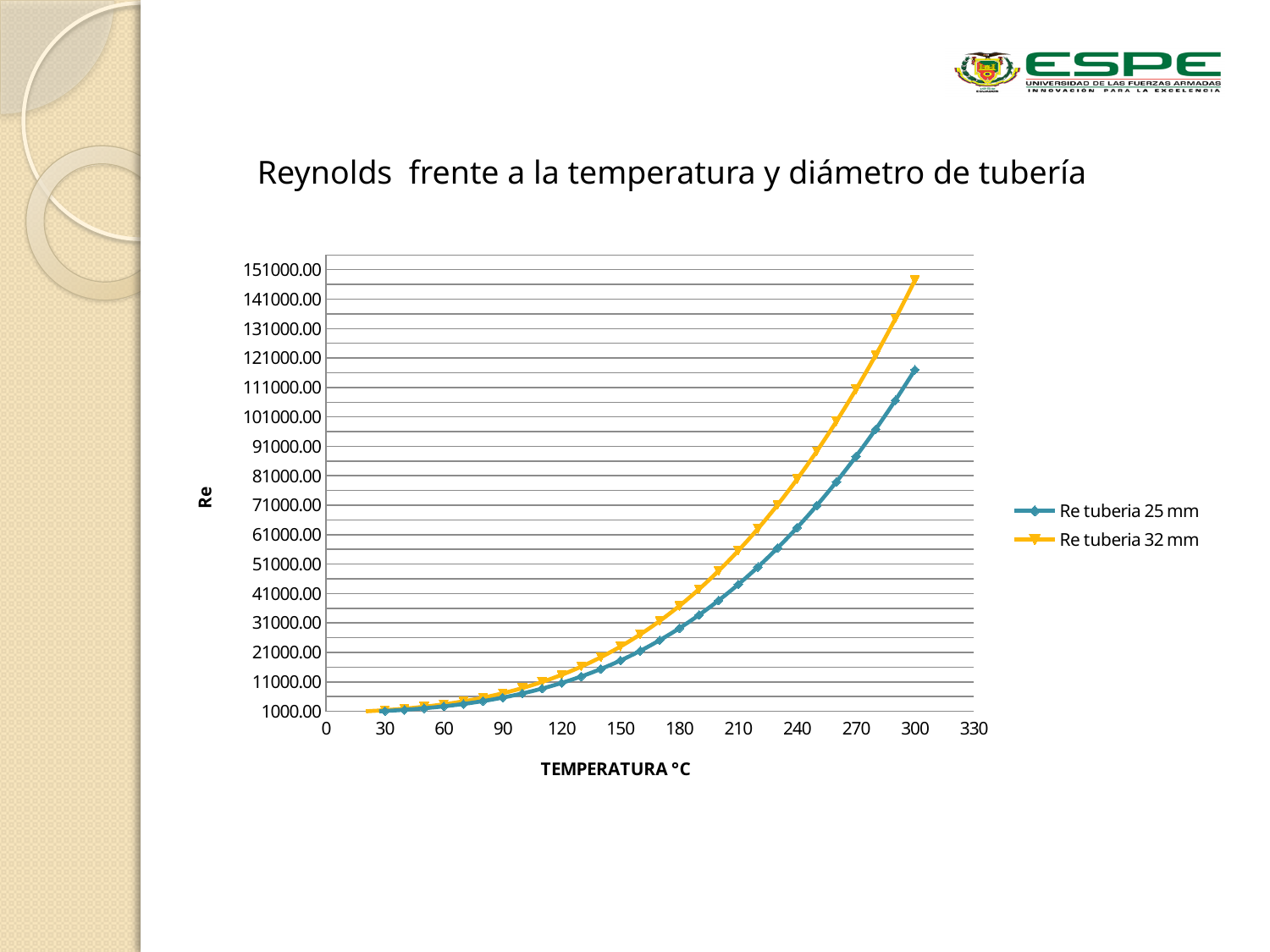
How many series does the legend list? 2 Is the value for Re tuberia 25 mm at 200 °C greater or less than 41000.00? less What is the title of the chart? Reynolds frente a la temperatura y diámetro de tubería Which series reaches the highest Re value on the chart? Re tuberia 32 mm Which series reaches the higher value at 300 °C, Re tuberia 25 mm or Re tuberia 32 mm? Re tuberia 32 mm What is the label of the x axis? TEMPERATURA °C What kind of chart is shown on the slide? line chart Is the value for Re tuberia 25 mm at 150 °C greater or less than 21000.00? less Do the values of Re tuberia 32 mm rise or fall as temperature increases? rise Is the value for Re tuberia 32 mm at 200 °C greater or less than 41000.00? greater